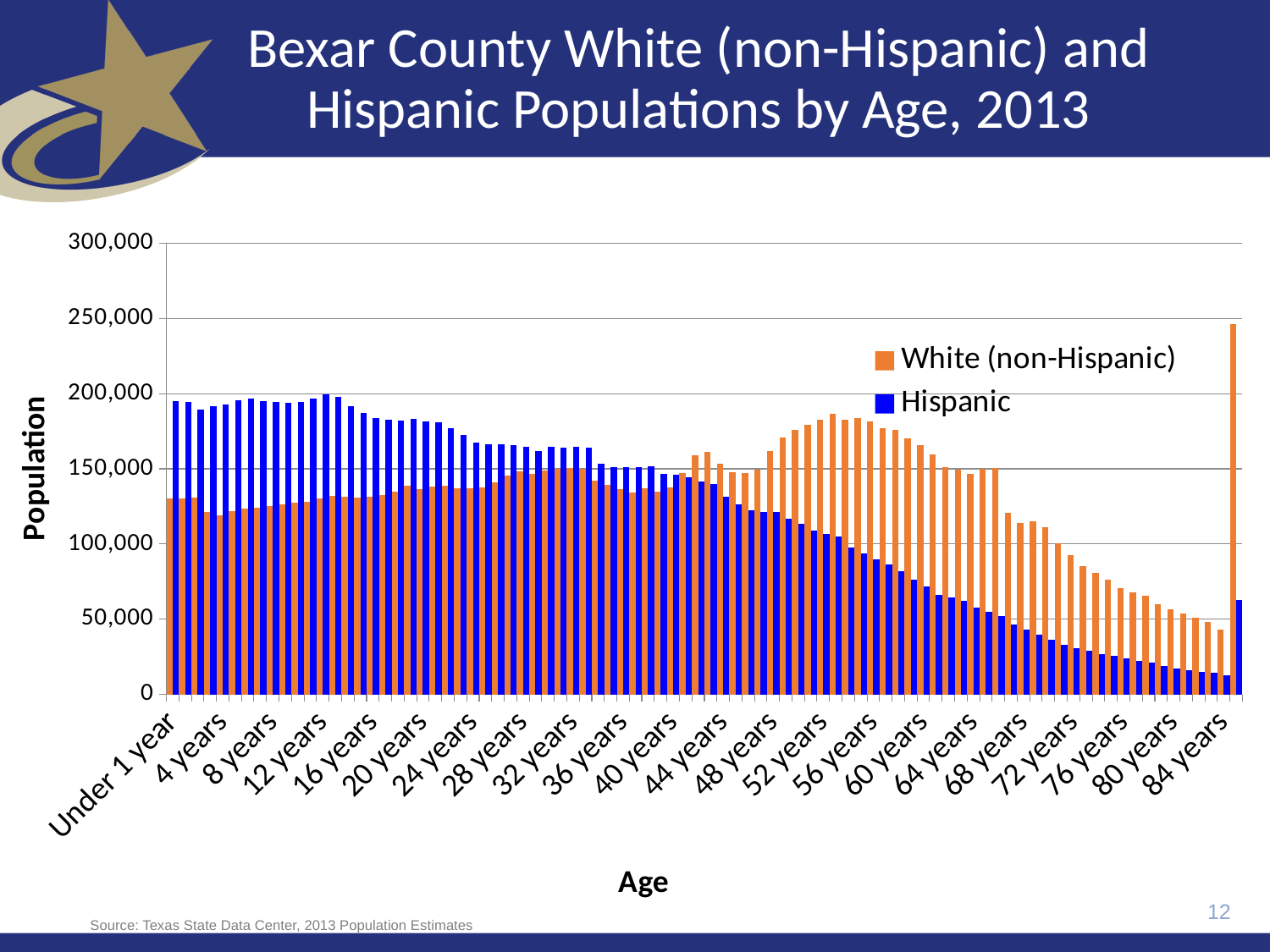
Is the White (non-Hispanic) value for 56 years greater or less than 150,000? greater Which two series are listed in the legend? White (non-Hispanic) and Hispanic How many series does the legend list? 2 At 56 years, which series has the larger value, White (non-Hispanic) or Hispanic? White (non-Hispanic) Is the White (non-Hispanic) value for 72 years greater or less than 100,000? less Do the Hispanic values generally rise or fall from 12 years to 84 years along the x axis? fall Is the Hispanic value for Under 1 year greater or less than 150,000? greater At 4 years, which series has the larger value, White (non-Hispanic) or Hispanic? Hispanic What is the title of the vertical axis? Population What kind of chart is shown on the slide? Bar chart